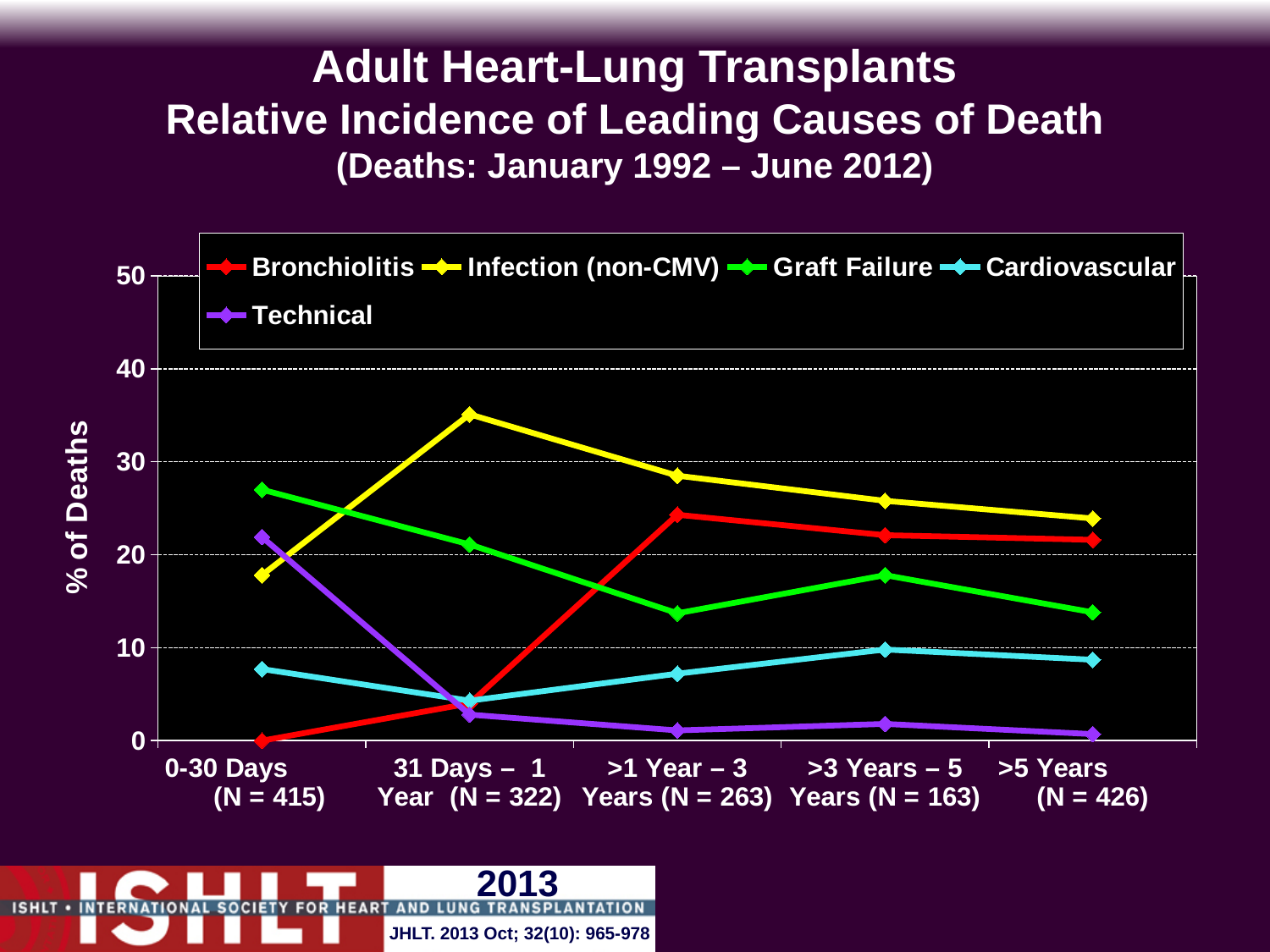
Which cause of death has the lowest % of Deaths at 0-30 Days? Bronchiolitis How many time-period categories are shown on the x axis? 5 At 0-30 Days, which is larger: Graft Failure or Infection (non-CMV)? Graft Failure Is the value for Infection (non-CMV) at 31 Days – 1 Year greater or less than 30? greater What kind of chart is shown on the slide? line chart Which cause of death has the lowest % of Deaths at >5 Years? Technical What is the value for Bronchiolitis at 0-30 Days? 0 Is the value for Cardiovascular at 0-30 Days greater or less than 10? less What is the label on the y axis? % of Deaths Which cause of death has the highest % of Deaths at 31 Days – 1 Year? Infection (non-CMV) How many series does the legend list? 5 Does the Technical series rise or fall from 0-30 Days to >5 Years? fall